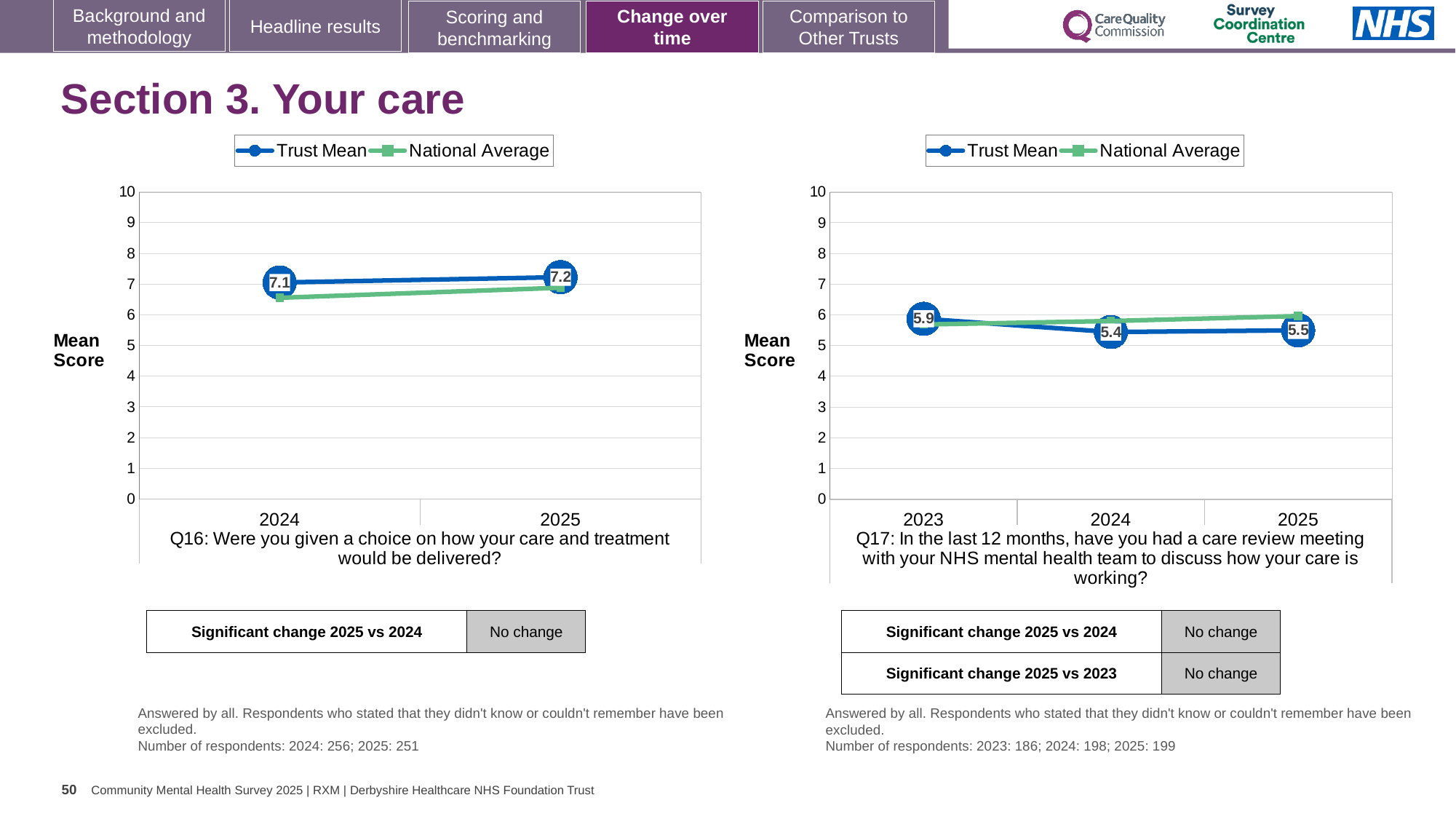
In the Q16 chart on the left, what is the Trust Mean score for 2024? 7.1 How many series does the legend of the Q16 chart on the left list? 2 In the Q16 chart on the left, is the Trust Mean score for 2025 larger or smaller than for 2024? larger In the Q17 chart on the right, which year has the lowest Trust Mean score? 2024 In the Q17 chart on the right, which year has the highest Trust Mean score? 2023 In the Q17 chart on the right, what is the Trust Mean score for 2024? 5.4 How many years are shown on the x axis of the Q17 chart on the right? 3 What type of chart is the Q17 chart on the right? line chart In the Q16 chart on the left, what is the Trust Mean score for 2025? 7.2 In the Q17 chart on the right, what is the Trust Mean score for 2023? 5.9 In the Q16 chart on the left, is the National Average value for 2024 greater or less than 6? greater In the Q17 chart on the right, what is the difference between the Trust Mean scores for 2023 and 2024? 0.5